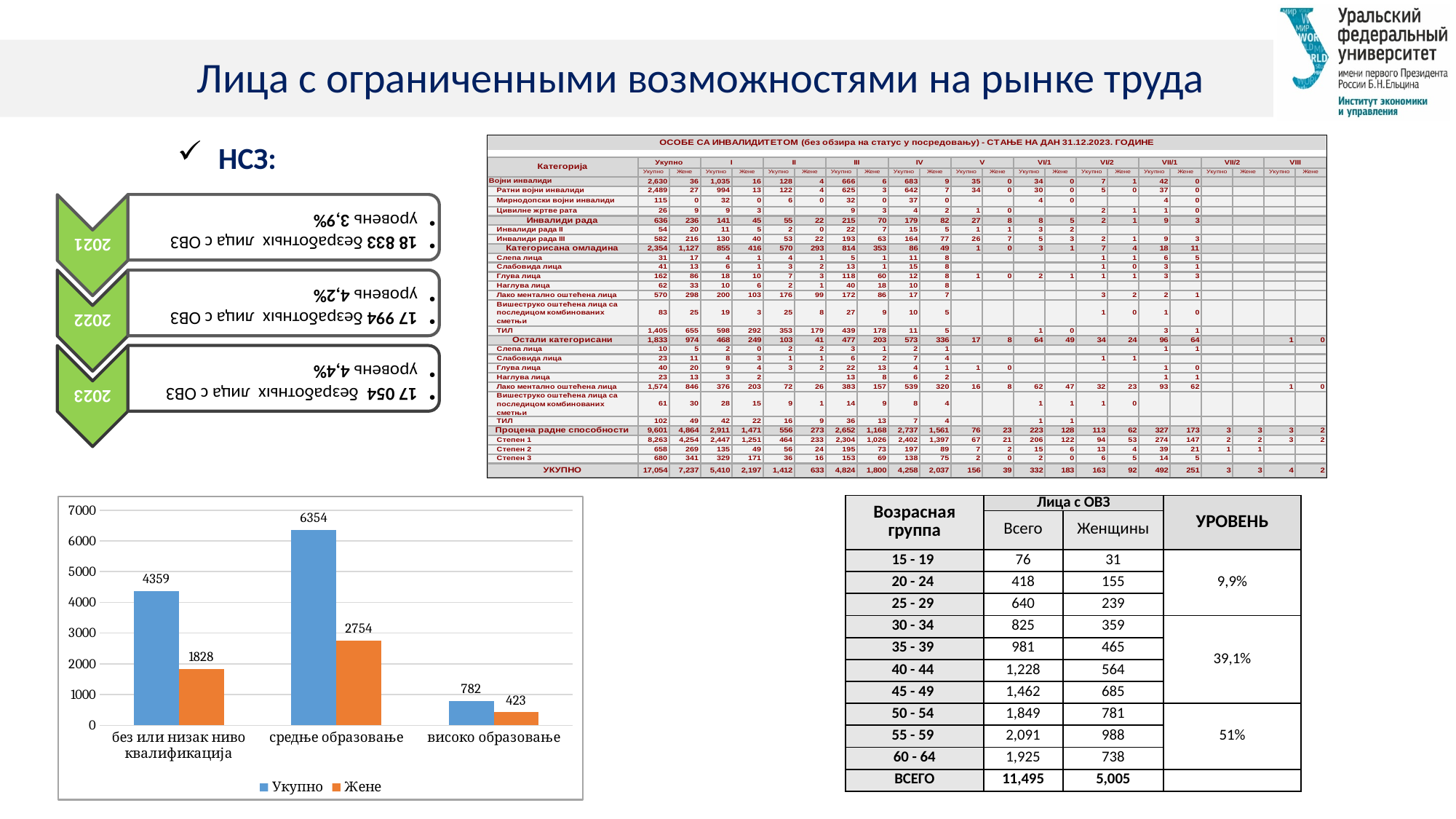
In the bar chart, which category has the highest Укупно value? средње образовање In the bar chart, which category has the lowest Жене value? високо образовање How many categories are shown on the x axis of the bar chart? 3 What type of chart is shown at the bottom left of the slide? bar chart In the bar chart, what is the value of Жене for без или низак ниво квалификација? 1828 In the bar chart, what is the difference between the Укупно values for средње образовање and без или низак ниво квалификација? 1995 In the bar chart, what is the difference between Укупно and Жене for средње образовање? 3600 In the bar chart, which is larger: Укупно for високо образовање or Жене for без или низак ниво квалификација? Жене for без или низак ниво квалификација In the bar chart, what colour are the Жене bars? orange How many series does the legend of the bar chart list? 2 In the bar chart, what is the value of Жене for високо образовање? 423 In the bar chart, what is the value of Укупно for средње образовање? 6354